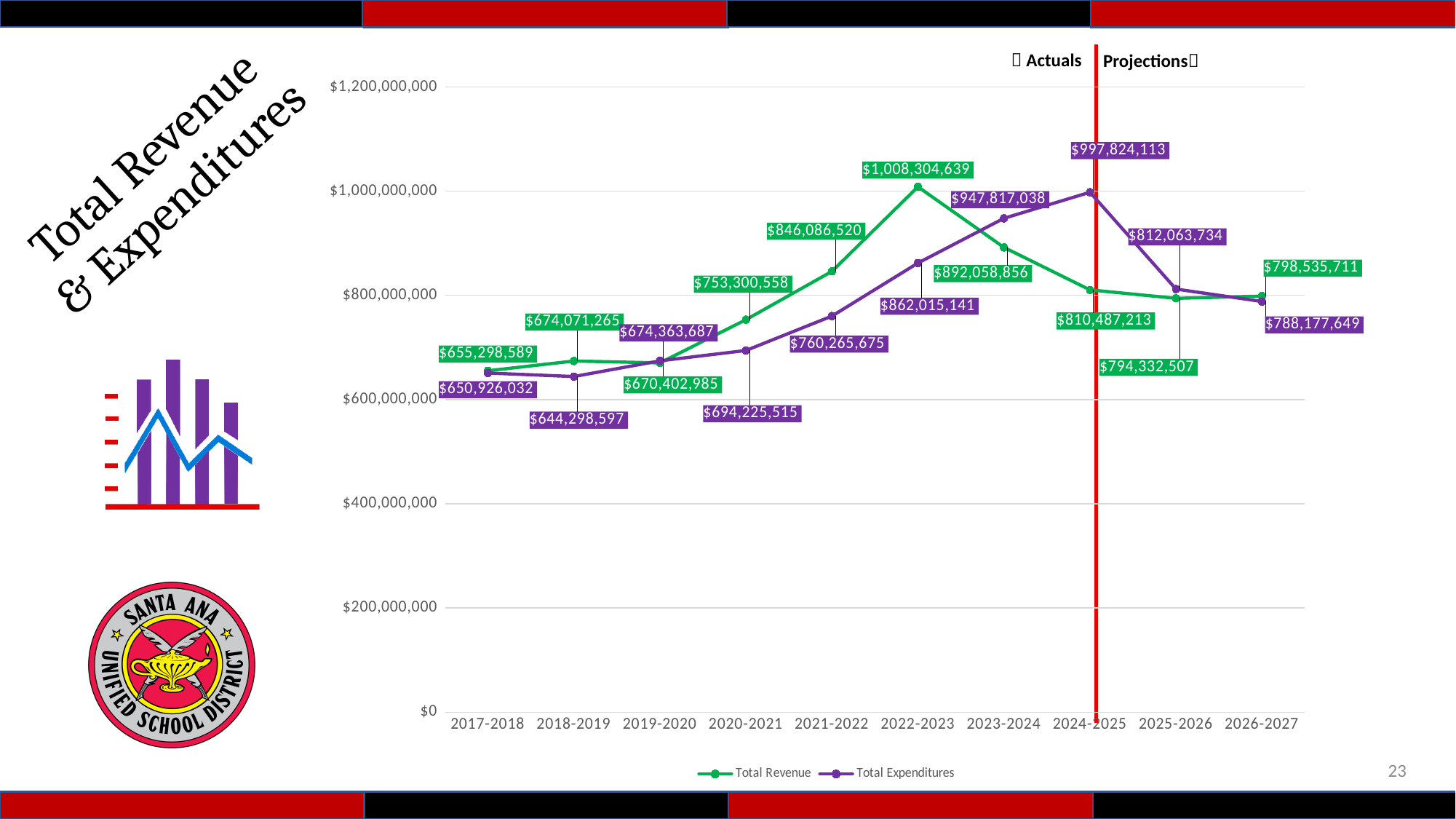
What kind of chart is shown on the slide? Line chart In which year is Total Revenue highest? 2022-2023 Is the Total Revenue value for 2021-2022 greater or less than $800,000,000? greater What colour is the Total Expenditures line? Purple In 2024-2025, which is larger: Total Revenue or Total Expenditures? Total Expenditures What is the difference between Total Revenue and Total Expenditures in 2022-2023? $146,289,498 How many fiscal years are shown on the x axis? 10 What is the Total Revenue value for 2022-2023? $1,008,304,639 What is the Total Expenditures value for 2024-2025? $997,824,113 In which year is Total Expenditures lowest? 2018-2019 Does Total Expenditures rise or fall from 2017-2018 to 2024-2025? Rise How many series does the legend list? 2